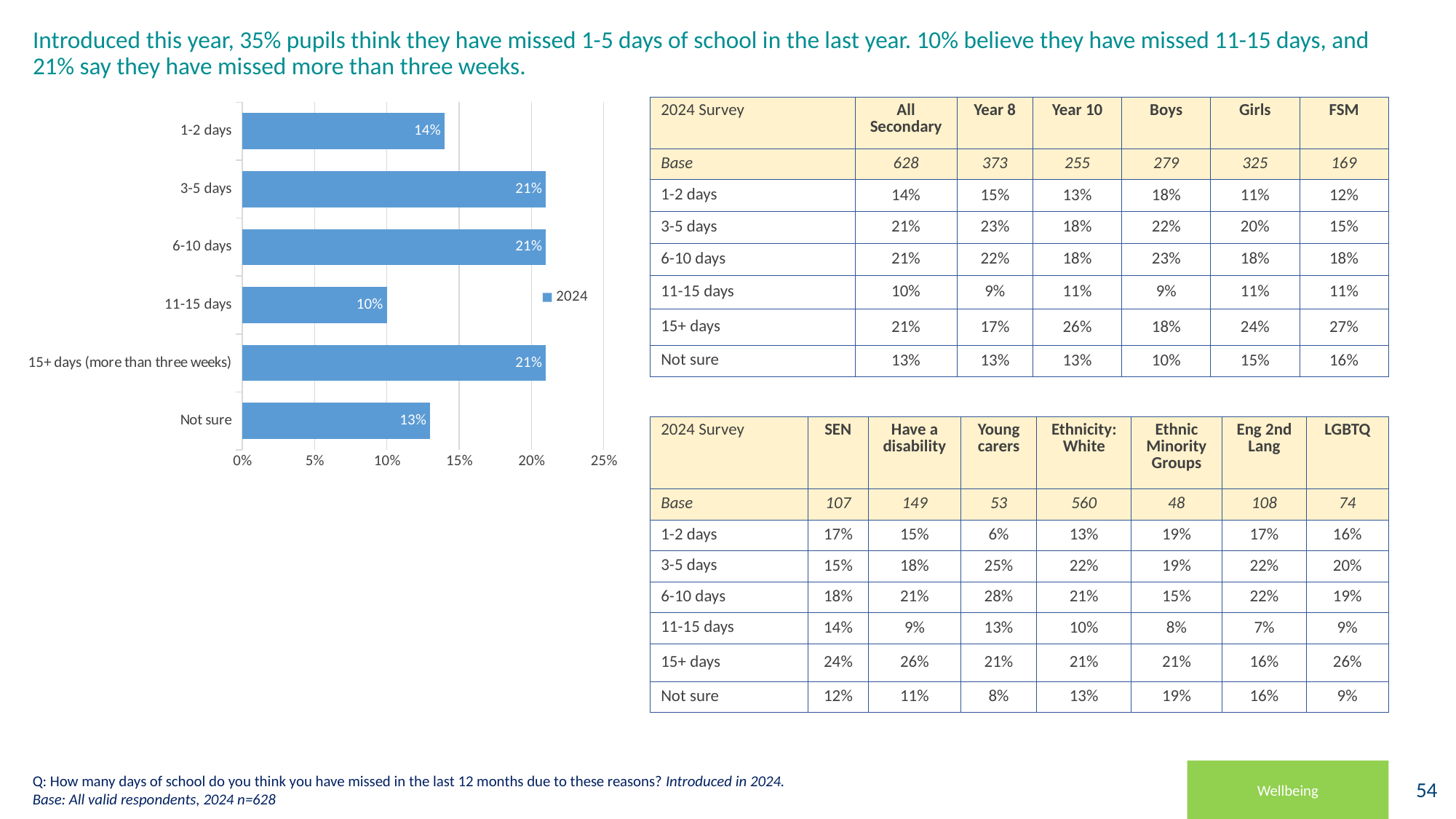
How many categories are shown in the bar chart? 6 Which category has the lowest value in the bar chart? 11-15 days What is the value for '11-15 days' in the bar chart? 10% What series name is shown in the legend of the bar chart? 2024 How many series does the legend of the bar chart list? 1 What is the value for '1-2 days' in the bar chart? 14% Is the value for '6-10 days' in the bar chart greater or less than 20%? greater Which is larger in the bar chart, the value for '1-2 days' or the value for 'Not sure'? 1-2 days What is the difference between the values for 'Not sure' and '11-15 days' in the bar chart? 3% What is the difference between the values for '3-5 days' and '1-2 days' in the bar chart? 7% What kind of chart is shown on the slide? Bar chart What is the value for 'Not sure' in the bar chart? 13%